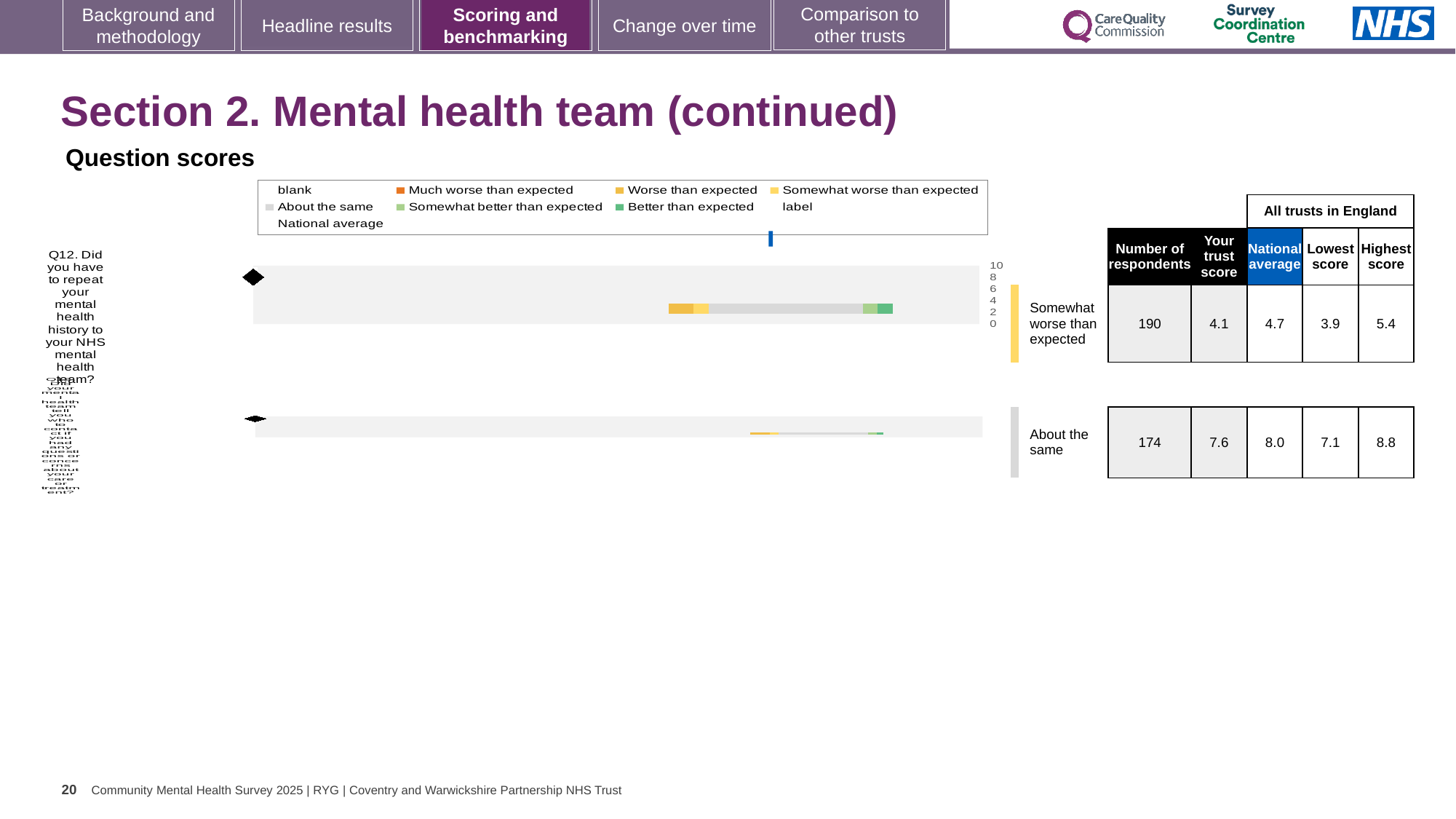
For Q12, which is larger: the trust score or the national average? National average How many questions are plotted on this chart? 2 What is the highest score among all trusts in England for Q12? 5.4 What is the national average score for Q12? 4.7 What is the lowest score among all trusts in England for Q12? 3.9 How many respondents answered Q12? 190 What is the trust score for Q12 (Did you have to repeat your mental health history to your NHS mental health team?)? 4.1 What is the trust score for the question benchmarked as 'About the same'? 7.6 Which benchmark category is Q12 placed in? Somewhat worse than expected By how much is the national average for Q12 higher than the trust score? 0.6 What kind of chart is shown on the slide? Bar chart What is the difference between the highest and lowest trust scores for Q12? 1.5